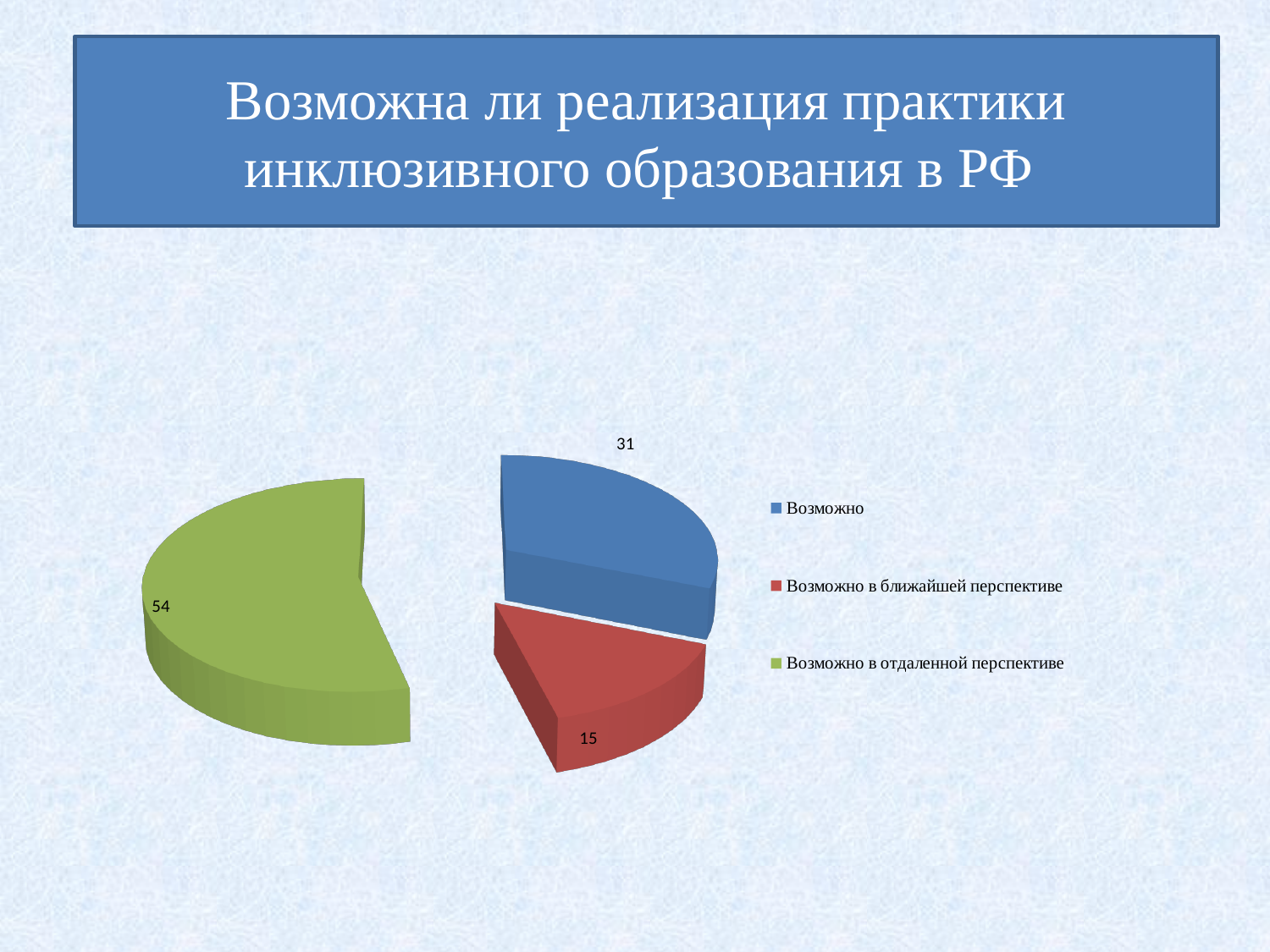
What is the difference between the values for "Возможно в отдаленной перспективе" and "Возможно"? 23 Which category has the smallest slice? Возможно в ближайшей перспективе What is the difference between the values for "Возможно" and "Возможно в ближайшей перспективе"? 16 What is the value for "Возможно"? 31 Which is larger, the value for "Возможно" or the value for "Возможно в ближайшей перспективе"? Возможно What is the value for "Возможно в отдаленной перспективе"? 54 What colour is the slice for "Возможно в отдаленной перспективе"? green What is the value for "Возможно в ближайшей перспективе"? 15 What is the total of all the slice values? 100 How many slices does the pie chart have? 3 What kind of chart is shown on the slide? pie chart Which category has the largest slice? Возможно в отдаленной перспективе